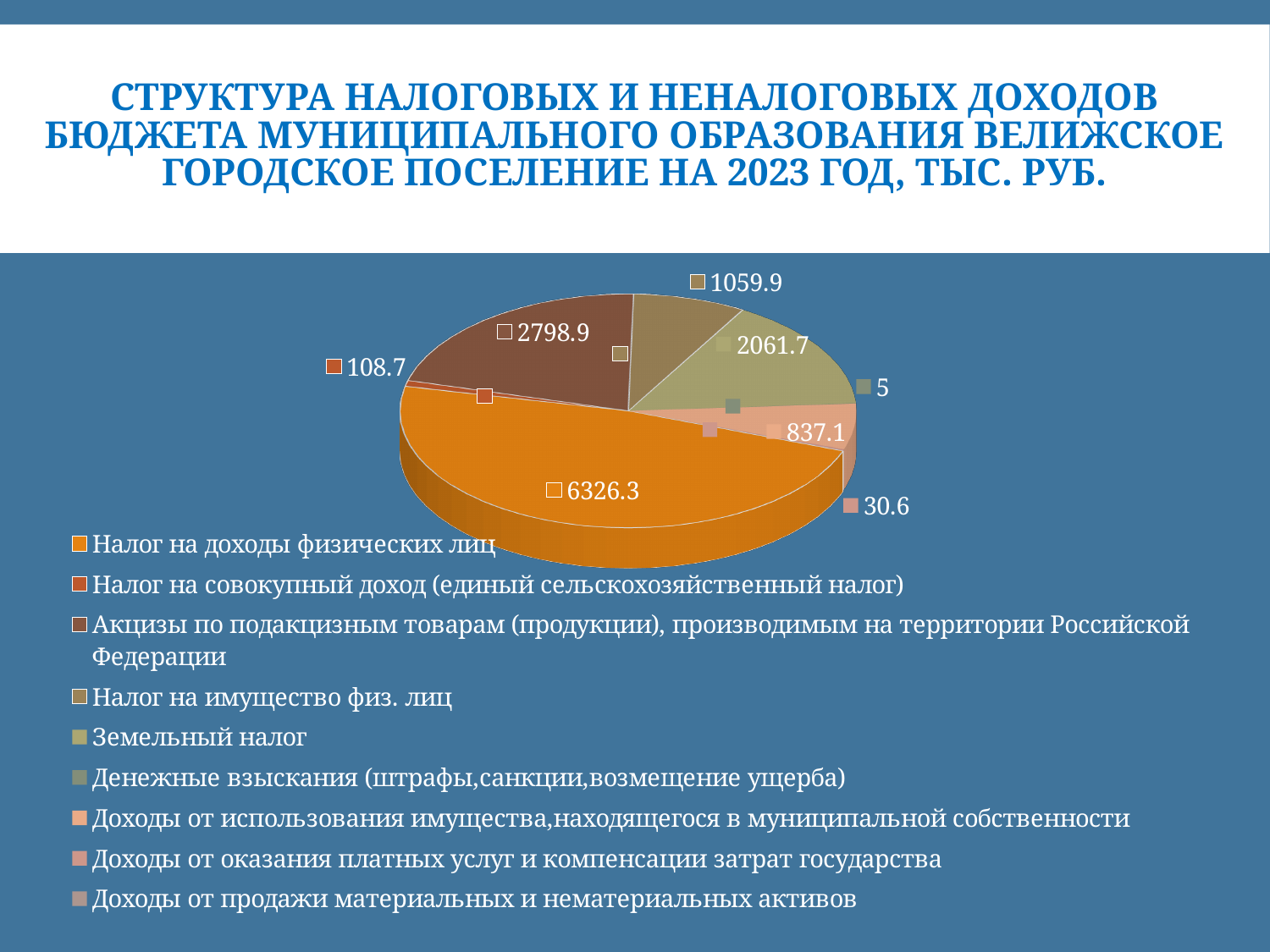
How many entries does the legend list? 9 Which is larger: the slice labelled 2061.7 or the slice labelled 1059.9? 2061.7 Which is larger: the value for Налог на доходы физических лиц or the value for Акцизы по подакцизным товарам? Налог на доходы физических лиц Which category has the largest slice of the pie? Налог на доходы физических лиц What is the value shown for Налог на доходы физических лиц? 6326.3 What is the value shown for Акцизы по подакцизным товарам (продукции), производимым на территории Российской Федерации? 2798.9 In what units are the values on the chart given, according to the slide title? тыс. руб. What is the largest value labelled on the pie chart? 6326.3 What kind of chart is shown on the slide? pie chart What is the smallest value labelled on the pie chart? 5 What is the difference between the values for Налог на доходы физических лиц and Акцизы по подакцизным товарам? 3527.4 What is the value shown for Налог на совокупный доход (единый сельскохозяйственный налог)? 108.7